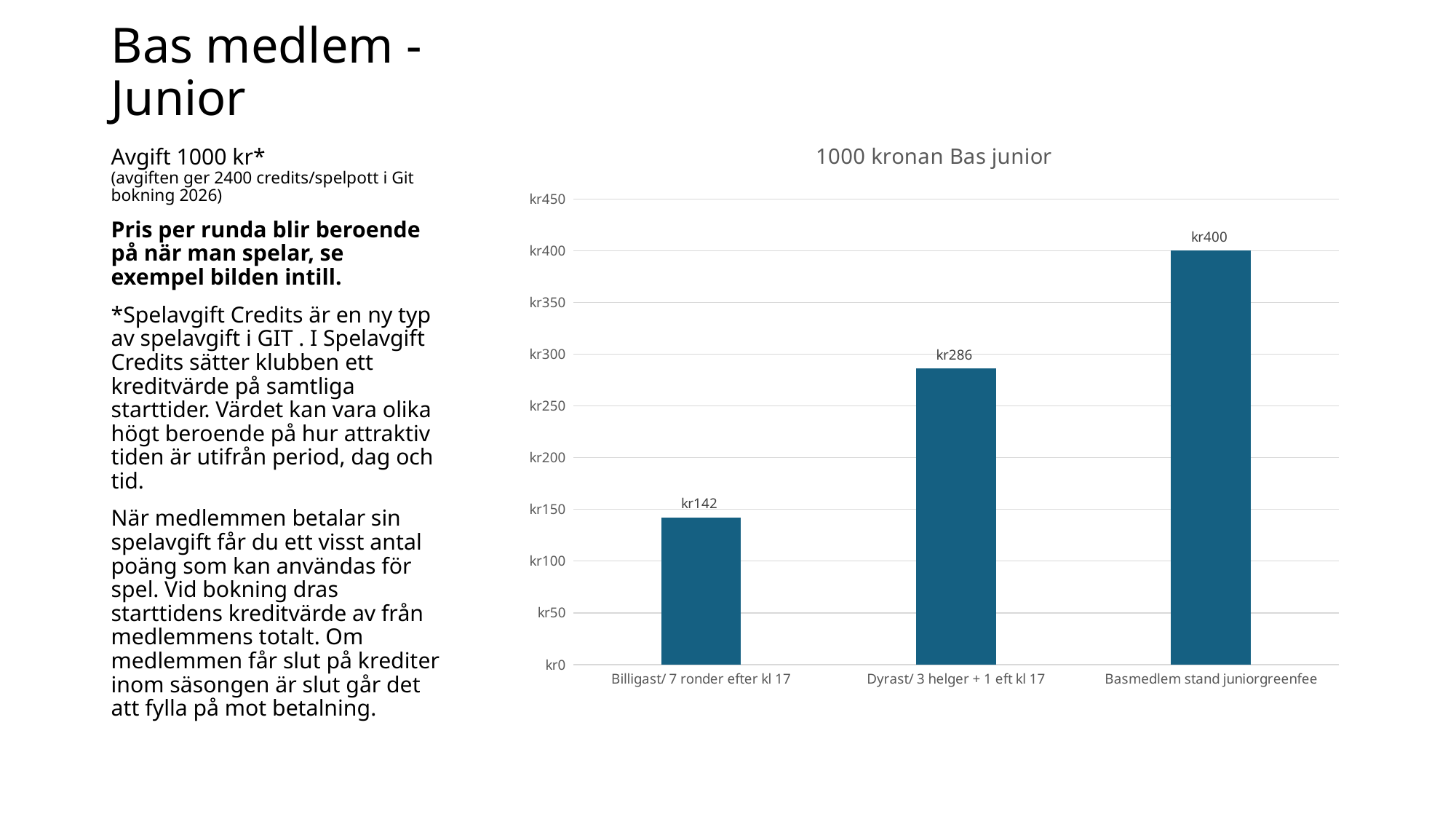
Which is larger, the value for "Dyrast/ 3 helger + 1 eft kl 17" or "Basmedlem stand juniorgreenfee"? Basmedlem stand juniorgreenfee What is the difference between the values for "Basmedlem stand juniorgreenfee" and "Billigast/ 7 ronder efter kl 17"? kr258 What is the title of the chart? 1000 kronan Bas junior Which category has the lowest value? Billigast/ 7 ronder efter kl 17 What kind of chart is shown on the slide? Bar chart What is the value for "Dyrast/ 3 helger + 1 eft kl 17"? kr286 What is the difference between the values for "Dyrast/ 3 helger + 1 eft kl 17" and "Billigast/ 7 ronder efter kl 17"? kr144 Is the value for "Dyrast/ 3 helger + 1 eft kl 17" greater or less than kr250? greater What is the value for "Billigast/ 7 ronder efter kl 17"? kr142 How many categories are shown in the chart? 3 Which category has the highest value? Basmedlem stand juniorgreenfee What is the value for "Basmedlem stand juniorgreenfee"? kr400